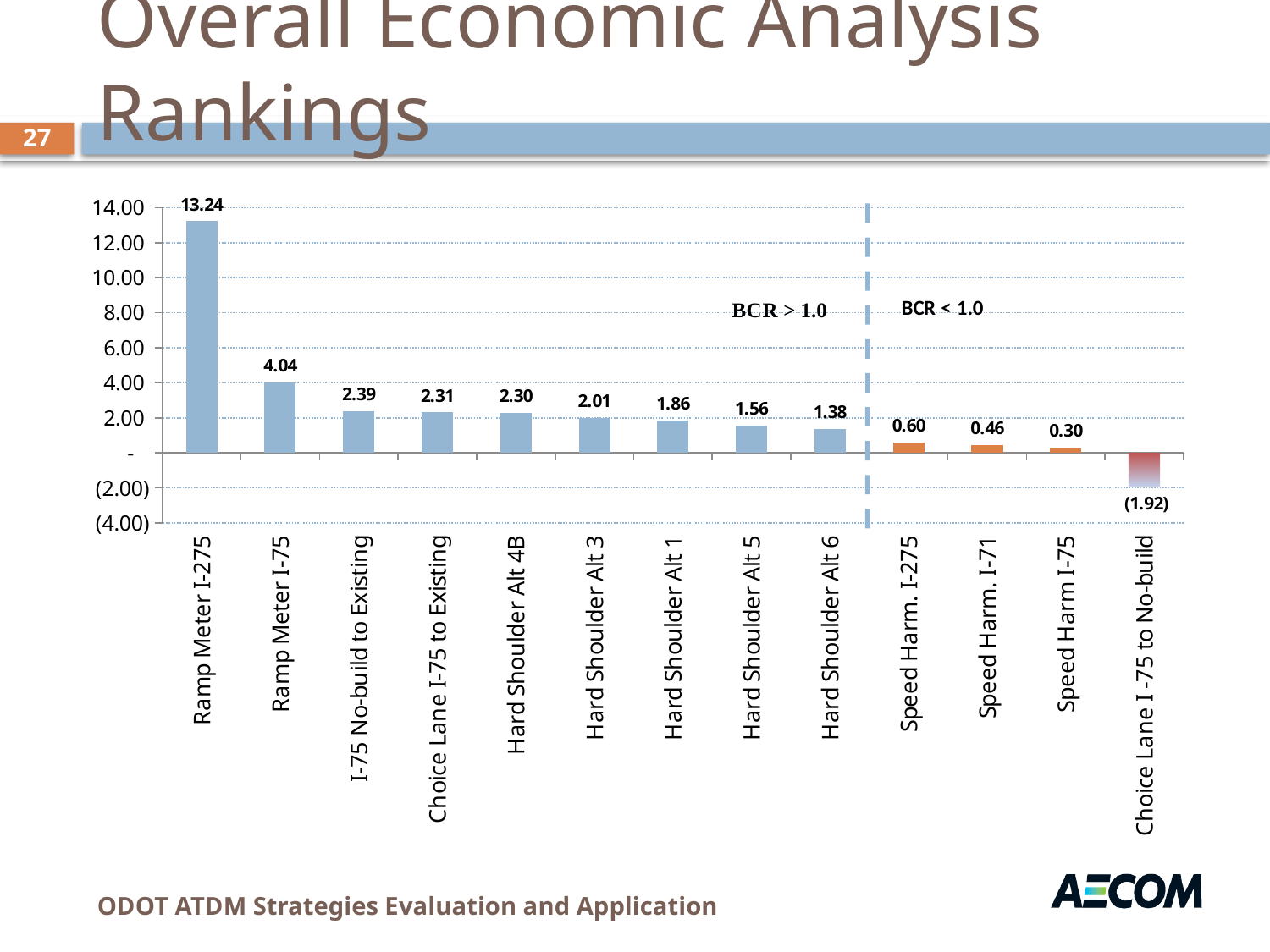
What kind of chart is shown on the slide? bar chart How many categories are shown on the x axis? 13 Is the value for Ramp Meter I-275 greater or less than 12.00? greater What is the difference between the values for Ramp Meter I-275 and Ramp Meter I-75? 9.20 What is the value for Hard Shoulder Alt 4B? 2.30 Which is larger, the value for Hard Shoulder Alt 3 or Hard Shoulder Alt 1? Hard Shoulder Alt 3 What is the value for Speed Harm. I-71? 0.46 What is the value for Ramp Meter I-275? 13.24 Which category has the highest value? Ramp Meter I-275 Which category has the lowest value? Choice Lane I-75 to No-build Do the values generally rise or fall from left to right along the x axis? fall What is the value for Choice Lane I-75 to No-build? (1.92)